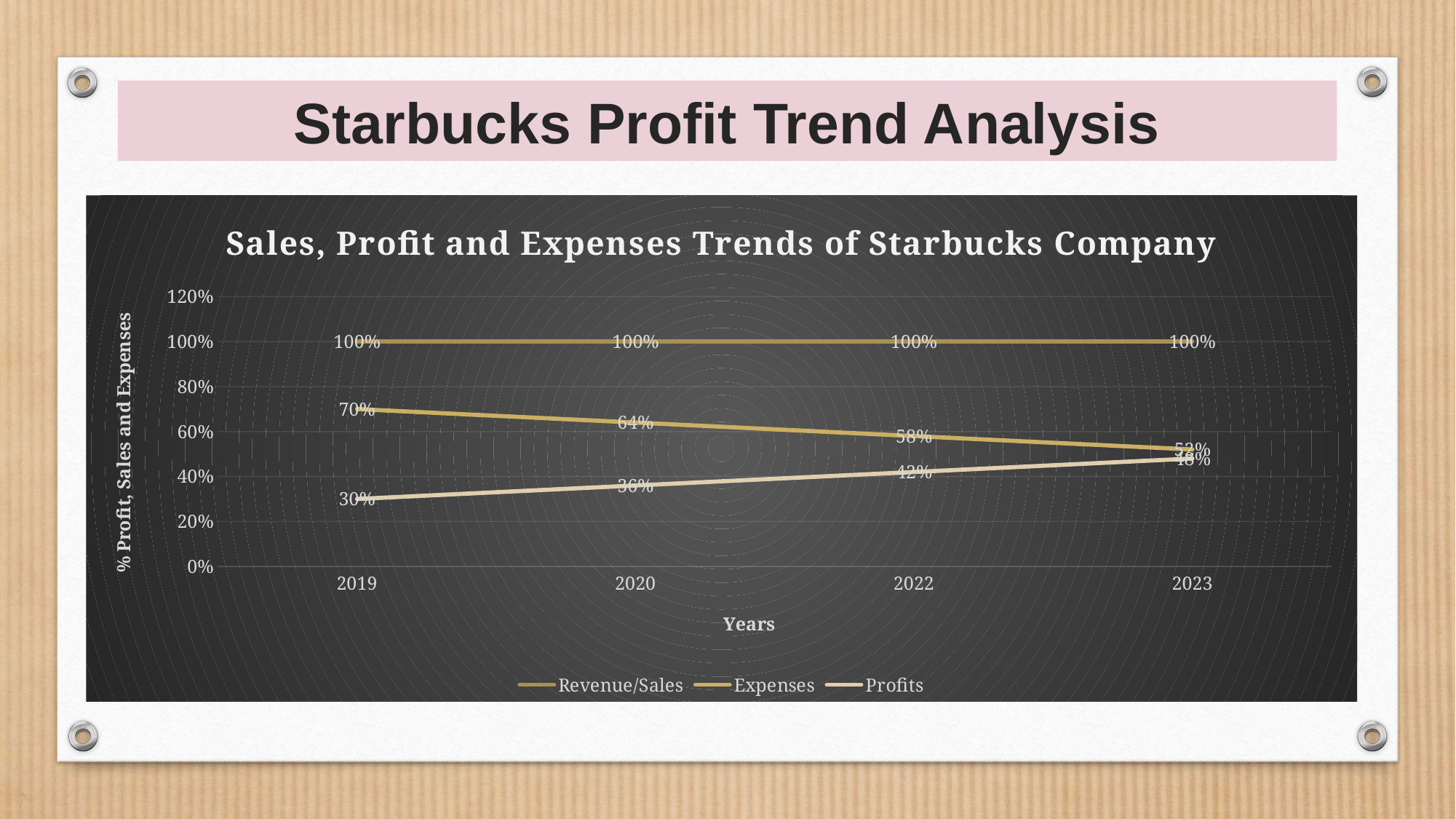
How many series does the legend list? 3 How many years are shown on the x axis? 4 What is the Revenue/Sales value for 2023? 100% What is the title of the chart? Sales, Profit and Expenses Trends of Starbucks Company What is the difference between Expenses and Profits in 2019? 40% In which year is the Profits value lowest? 2019 What is the Expenses value for 2022? 58% Is the Profits value for 2023 greater or less than 40%? greater What is the Expenses value for 2019? 70% What type of chart is shown on the slide? line chart Do the Expenses values rise or fall from 2019 to 2023? fall What is the Profits value for 2020? 36%